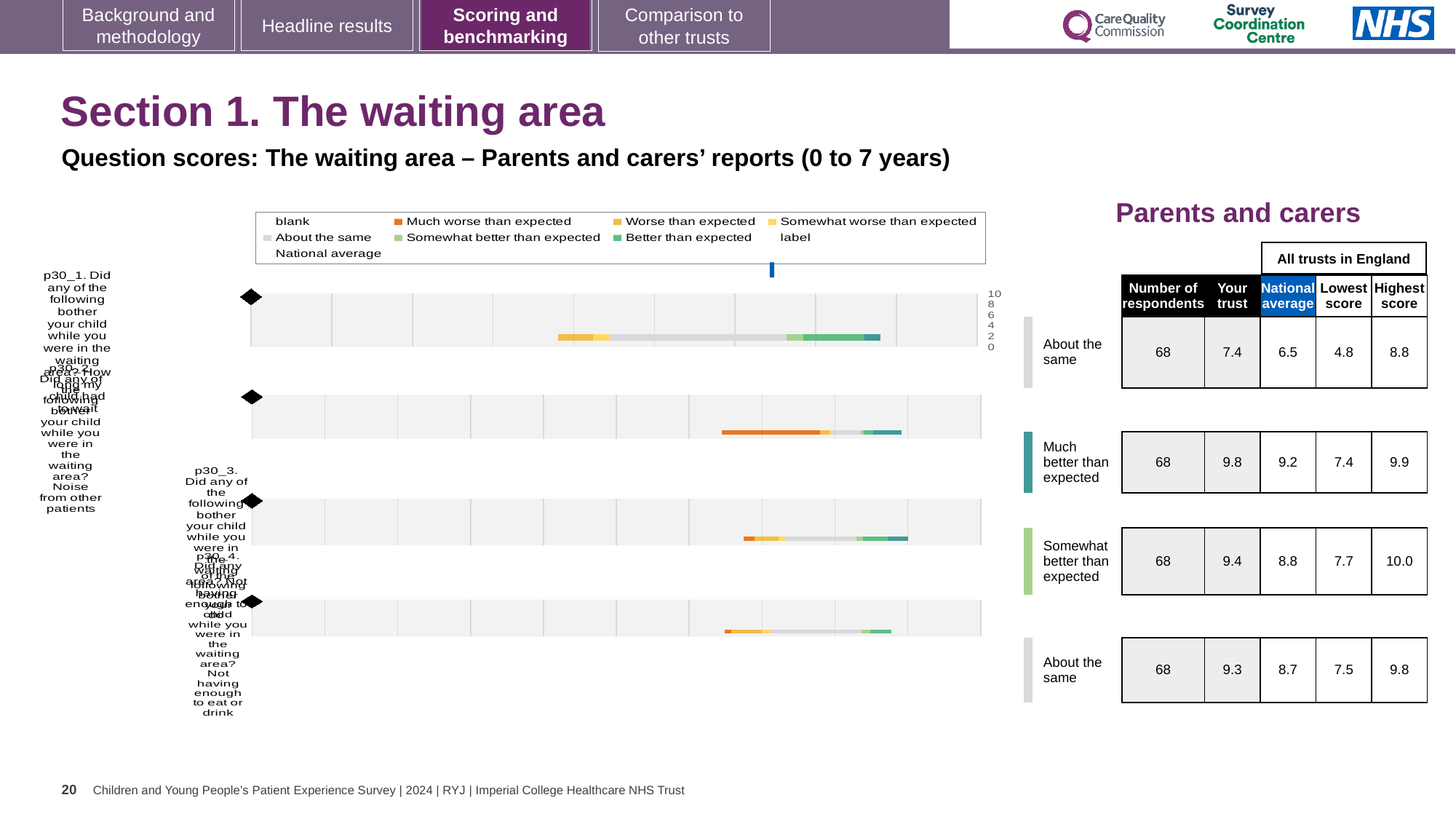
For the first question row, what is the difference between the 'Your trust' score and the national average? 0.9 How many respondents are listed for each question row? 68 Which question row has the lowest 'Your trust' score? the first row (About the same), 7.4 For the third question row, which is larger: the 'Your trust' score or the national average? Your trust (9.4) What kind of chart is shown on the left of the slide? bar chart What is the 'Your trust' score for the first question row (About the same)? 7.4 What is the national average for the second question row (Much better than expected)? 9.2 In the chart legend, which colour represents 'Much worse than expected'? orange What is the highest score across all trusts in England for the third question row (Somewhat better than expected)? 10.0 How many question rows (bars) are plotted in the chart? 4 Which question row has the highest 'Your trust' score? the second row (Much better than expected), 9.8 What is the lowest score across all trusts in England for the fourth question row (About the same)? 7.5